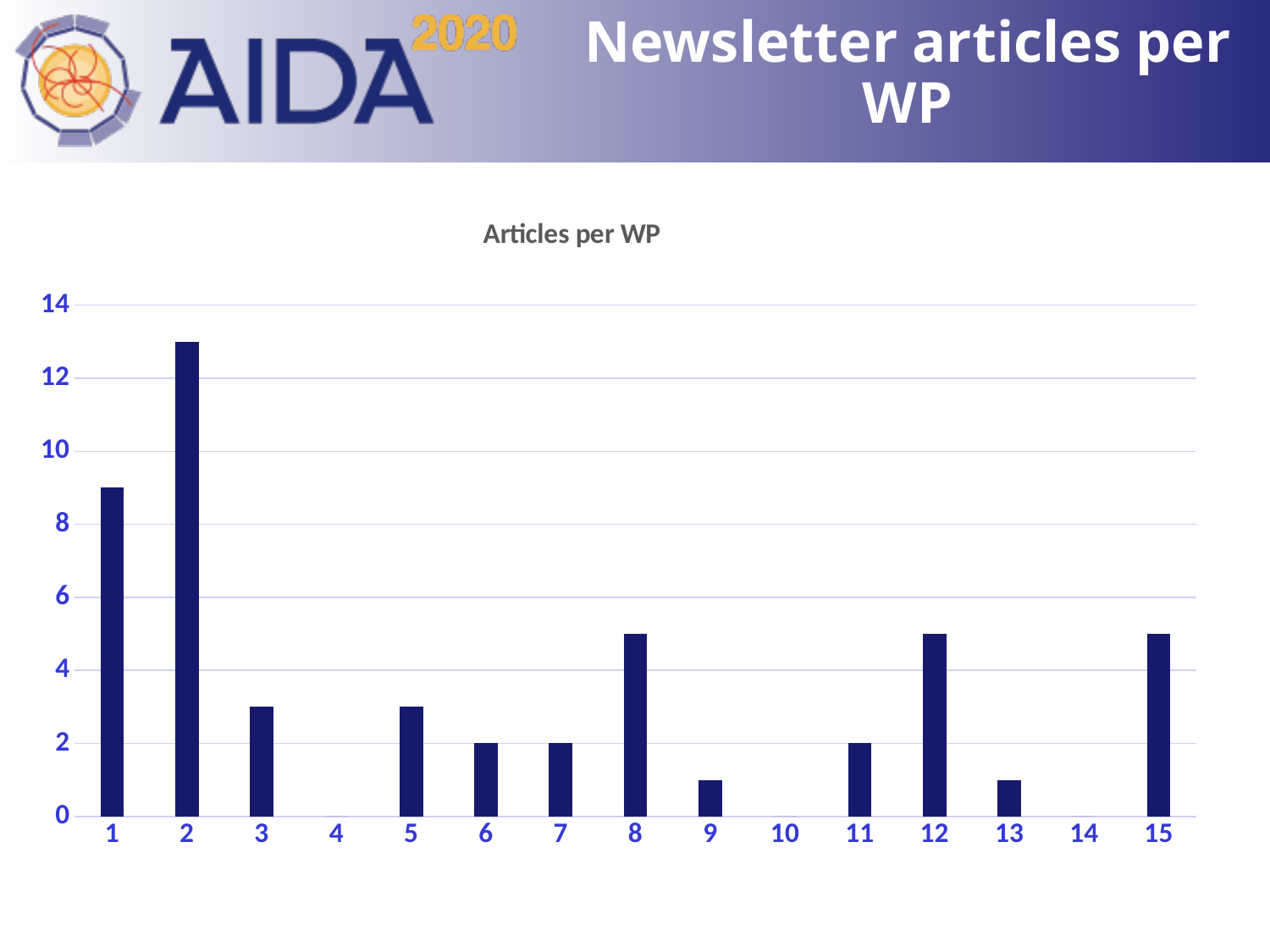
Is the value for WP 8 greater or less than 4? greater What type of chart is shown on the slide? bar chart How many articles does WP 6 have? 2 Which WP has the highest number of articles? 2 Is the value for WP 1 greater or less than 8? greater How many WP categories are shown on the x axis? 15 How many articles does WP 11 have? 2 Which has more articles, WP 1 or WP 8? WP 1 Is the value for WP 2 greater or less than 12? greater What is the title of the chart? Articles per WP How many articles does WP 4 have? 0